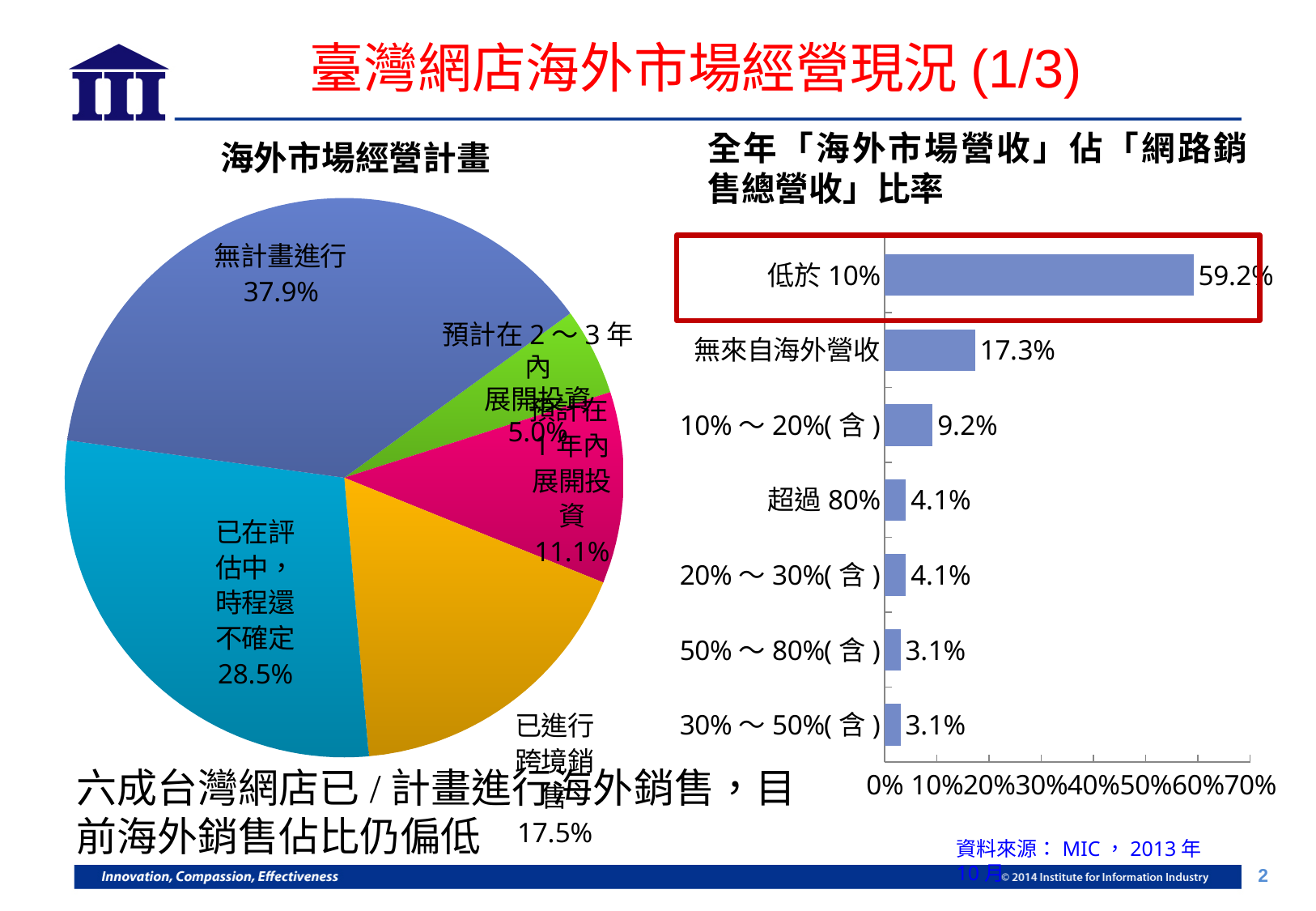
In the bar chart on the right, what is the difference between the values for 低於 10% and 無來自海外營收? 41.9% In the pie chart 海外市場經營計畫, what share is labelled for 無計畫進行? 37.9% In the bar chart on the right, which category has the highest value? 低於 10% In the pie chart 海外市場經營計畫, what share is labelled for 已在評估中，時程還不確定? 28.5% In the bar chart on the right, what is the value for 低於 10%? 59.2% In the bar chart on the right, how many categories are shown? 7 In the bar chart on the right, what is the value for 無來自海外營收? 17.3% In the pie chart 海外市場經營計畫, what is the difference between the shares for 已在評估中，時程還不確定 and 已進行跨境銷售? 11.0% What kind of chart is the chart on the right of the slide? Bar chart In the pie chart 海外市場經營計畫, which slice is the smallest? 預計在2～3年內展開投資 In the pie chart 海外市場經營計畫, which slice is the largest? 無計畫進行 In the pie chart 海外市場經營計畫, how many slices are there? 5